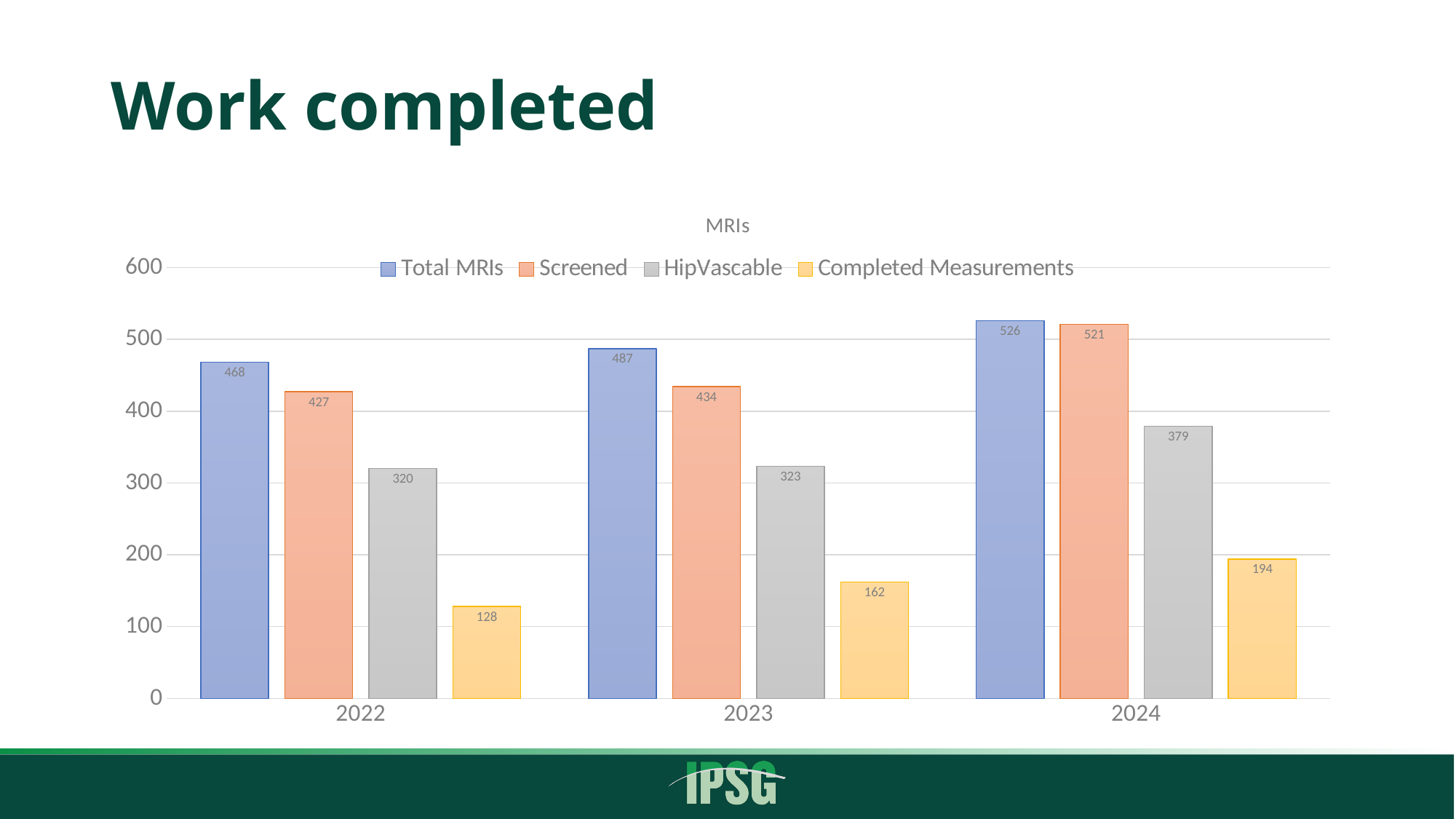
What is the value for Screened in 2022? 427 In which year is the Completed Measurements value highest? 2024 Which is larger in 2024: HipVascable or Completed Measurements? HipVascable How many years are shown on the x axis? 3 In which year is the Total MRIs value lowest? 2022 How many series does the legend list? 4 Do the Screened values rise or fall from 2022 to 2024? Rise What is the value for HipVascable in 2023? 323 What is the value for Total MRIs in 2024? 526 What kind of chart is shown on the slide? Bar chart What is the difference between Total MRIs and Screened in 2023? 53 What is the value for Completed Measurements in 2022? 128